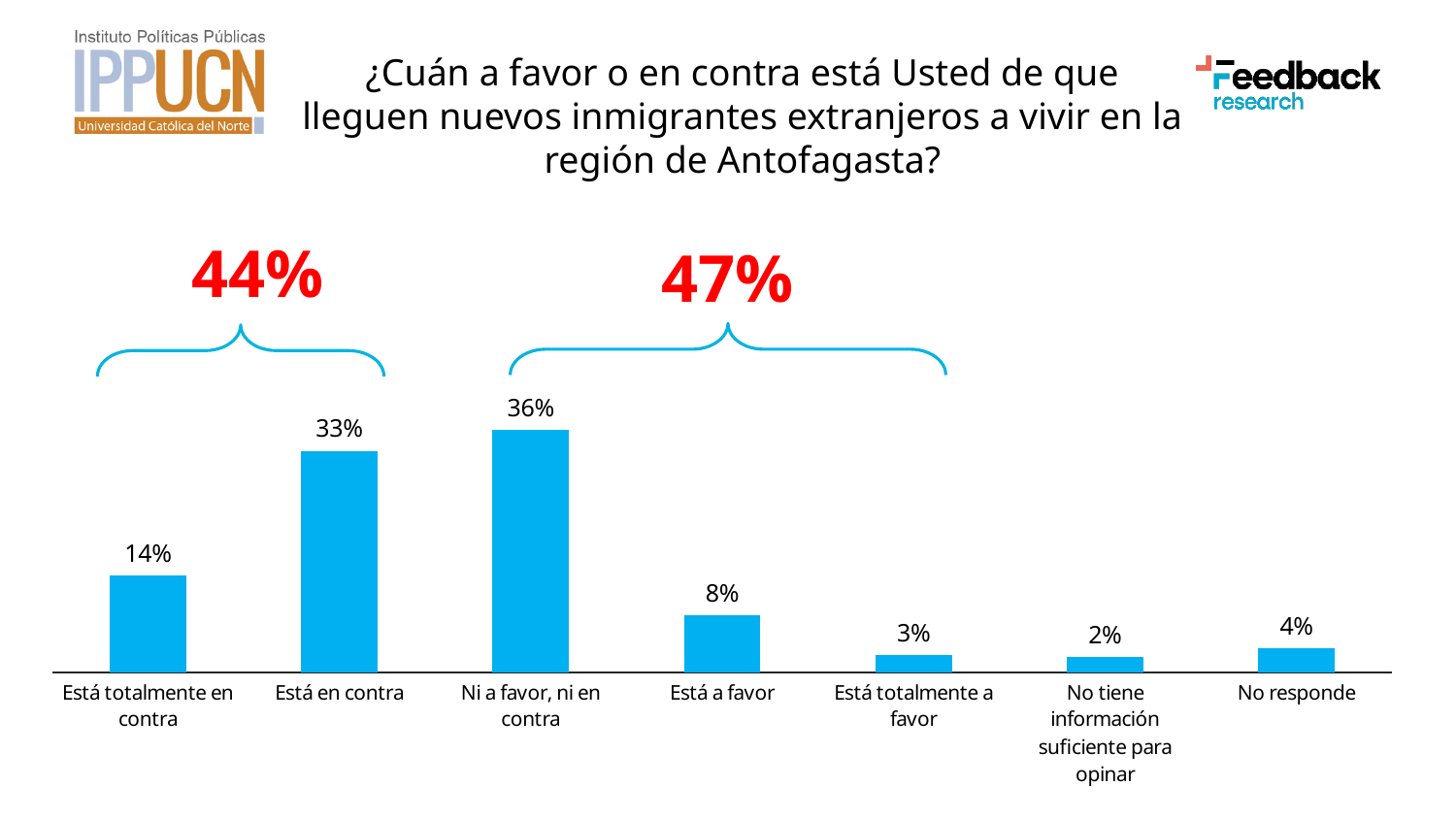
What is the difference between the values for "Está en contra" and "Está totalmente en contra"? 19% What percentage is printed above the bracket spanning "Ni a favor, ni en contra" through "Está totalmente a favor"? 47% How many categories are shown on the x axis? 7 What percentage is printed above the bracket spanning the first two categories? 44% Which is larger, the value for "Está a favor" or the value for "No responde"? Está a favor What is the value for "Ni a favor, ni en contra"? 36% What kind of chart is shown on the slide? Bar chart Which category has the lowest value? No tiene información suficiente para opinar Which category has the highest value? Ni a favor, ni en contra What is the value for "No responde"? 4% What is the value for "Está totalmente a favor"? 3% What is the value for "Está en contra"? 33%